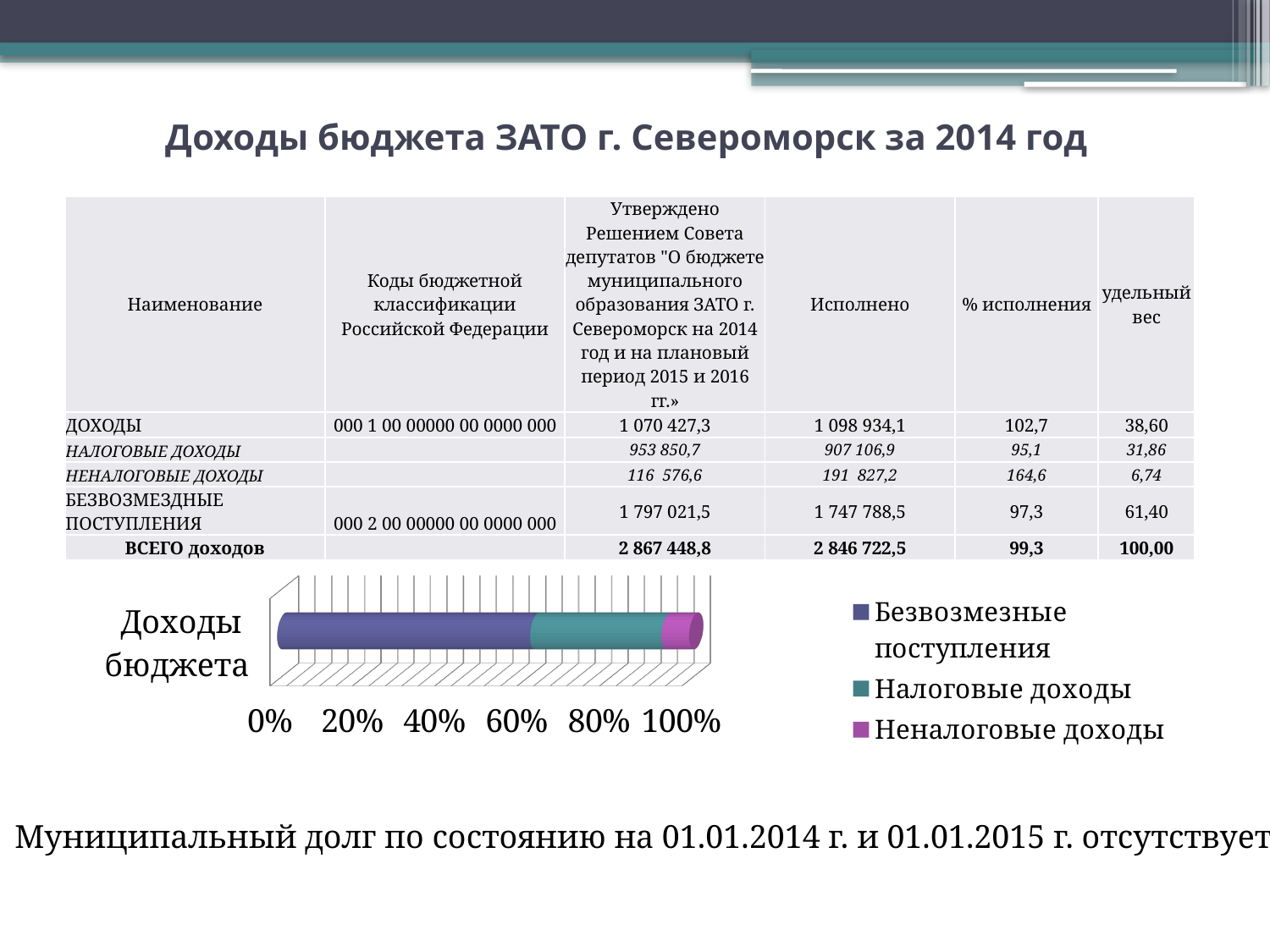
Is the share of the bar taken by Налоговые доходы greater or less than 40%? less What is the highest tick value shown on the chart's horizontal axis? 100% In the chart, which segment is larger: Безвозмезные поступления or Налоговые доходы? Безвозмезные поступления How many series does the chart legend list? 3 How many categories are plotted on the chart's category axis? 1 What kind of chart is shown on the slide? bar chart Is the share of the bar taken by Неналоговые доходы greater or less than 20%? less Is the share of the bar taken by Безвозмезные поступления greater or less than 40%? greater Which series occupies the largest segment of the bar in the chart? Безвозмезные поступления Which series occupies the smallest segment of the bar in the chart? Неналоговые доходы In the chart, which segment is larger: Налоговые доходы or Неналоговые доходы? Налоговые доходы What is the label of the single category on the chart's vertical axis? Доходы бюджета